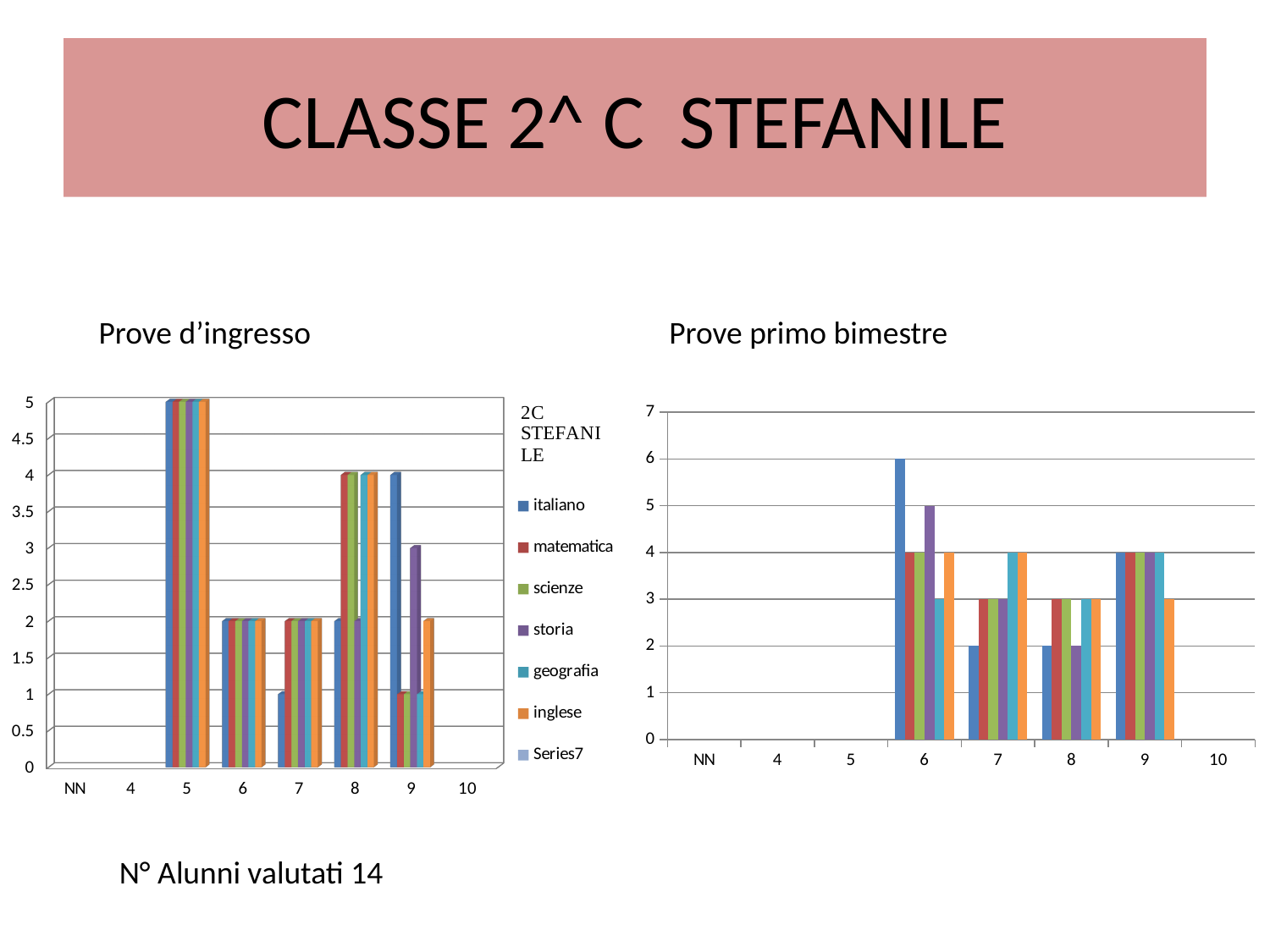
In the 'Prove primo bimestre' chart, which category contains the tallest bar? 6 What is the title shown in the legend area of the 'Prove d'ingresso' chart? 2C STEFANILE How many series does the legend of the 'Prove d'ingresso' chart list? 7 In the 'Prove d'ingresso' chart, what is the value for italiano at category 7? 1 In the 'Prove d'ingresso' chart, which category has the highest values across all series? 5 In the 'Prove d'ingresso' chart, what is the value for italiano at category 9? 4 In the 'Prove d'ingresso' chart, what is the difference between the italiano value at category 9 and the italiano value at category 7? 3 In the 'Prove primo bimestre' chart, is the tallest bar at category 6 greater or less than 5? greater In the 'Prove d'ingresso' chart, what is the value for storia at category 9? 3 How many categories are shown on the x axis of the 'Prove primo bimestre' chart? 8 What type of chart is the 'Prove d'ingresso' chart? bar chart In the 'Prove d'ingresso' chart, at category 8, which is larger: the value for matematica or the value for italiano? matematica